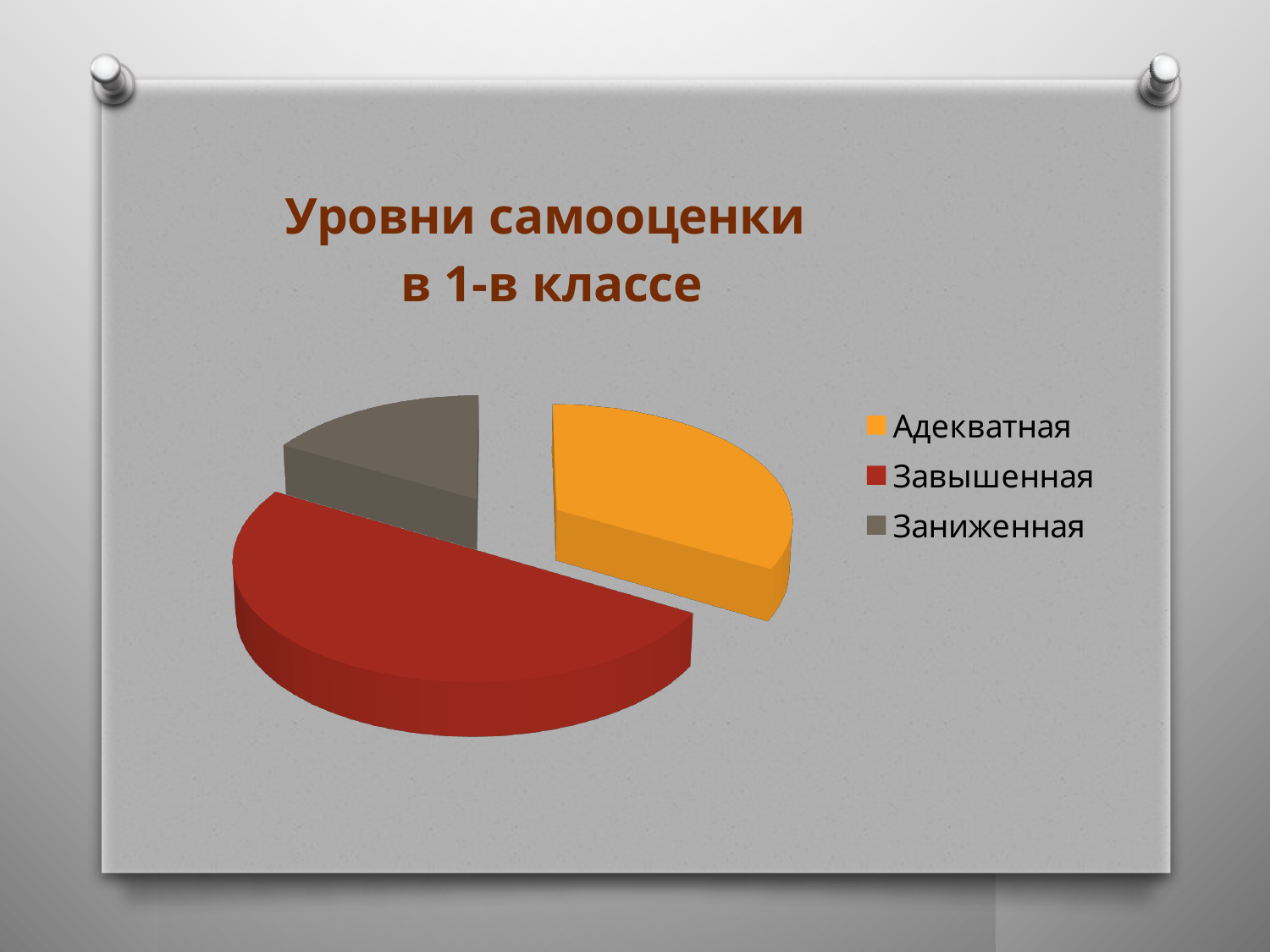
What kind of chart is shown on the slide? pie chart Which colour represents Завышенная in the pie chart? red How many slices does the pie chart have? 3 Which slice is larger, Адекватная or Заниженная? Адекватная Which category has the largest slice of the pie? Завышенная Which slice is larger, Завышенная or Адекватная? Завышенная Which category has the smallest slice of the pie? Заниженная What is the title of the chart? Уровни самооценки в 1-в классе How many entries does the legend list? 3